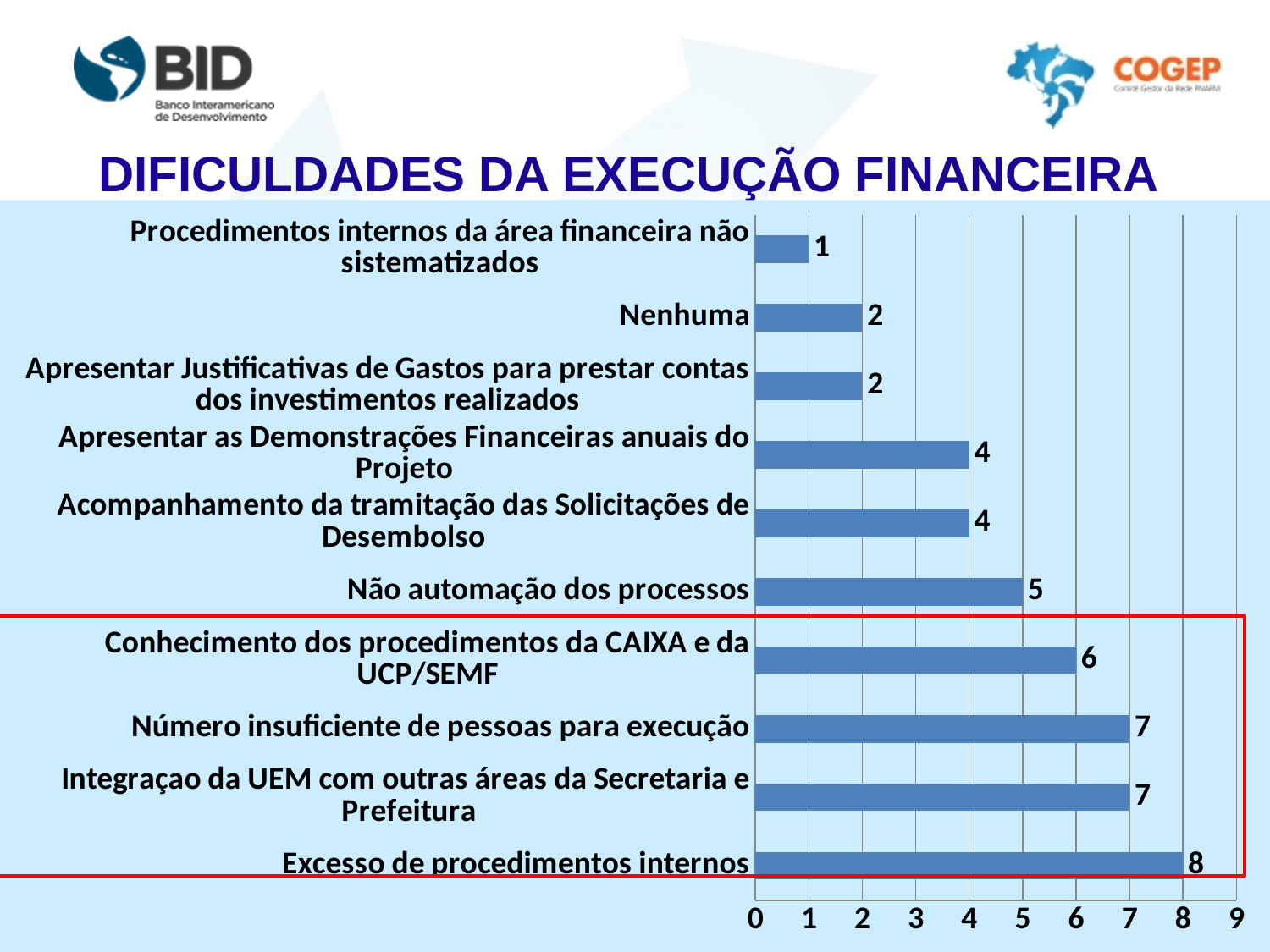
How many categories are shown in the chart? 10 What is the value for "Não automação dos processos"? 5 What is the title of the slide? DIFICULDADES DA EXECUÇÃO FINANCEIRA What is the value for "Acompanhamento da tramitação das Solicitações de Desembolso"? 4 What is the value for "Conhecimento dos procedimentos da CAIXA e da UCP/SEMF"? 6 Which is larger: the value for "Número insuficiente de pessoas para execução" or the value for "Conhecimento dos procedimentos da CAIXA e da UCP/SEMF"? Número insuficiente de pessoas para execução What is the value for "Excesso de procedimentos internos"? 8 Which category has the lowest value? Procedimentos internos da área financeira não sistematizados What is the value for "Nenhuma"? 2 What is the difference between the values for "Excesso de procedimentos internos" and "Não automação dos processos"? 3 What kind of chart is shown on the slide? Bar chart Which category has the highest value? Excesso de procedimentos internos